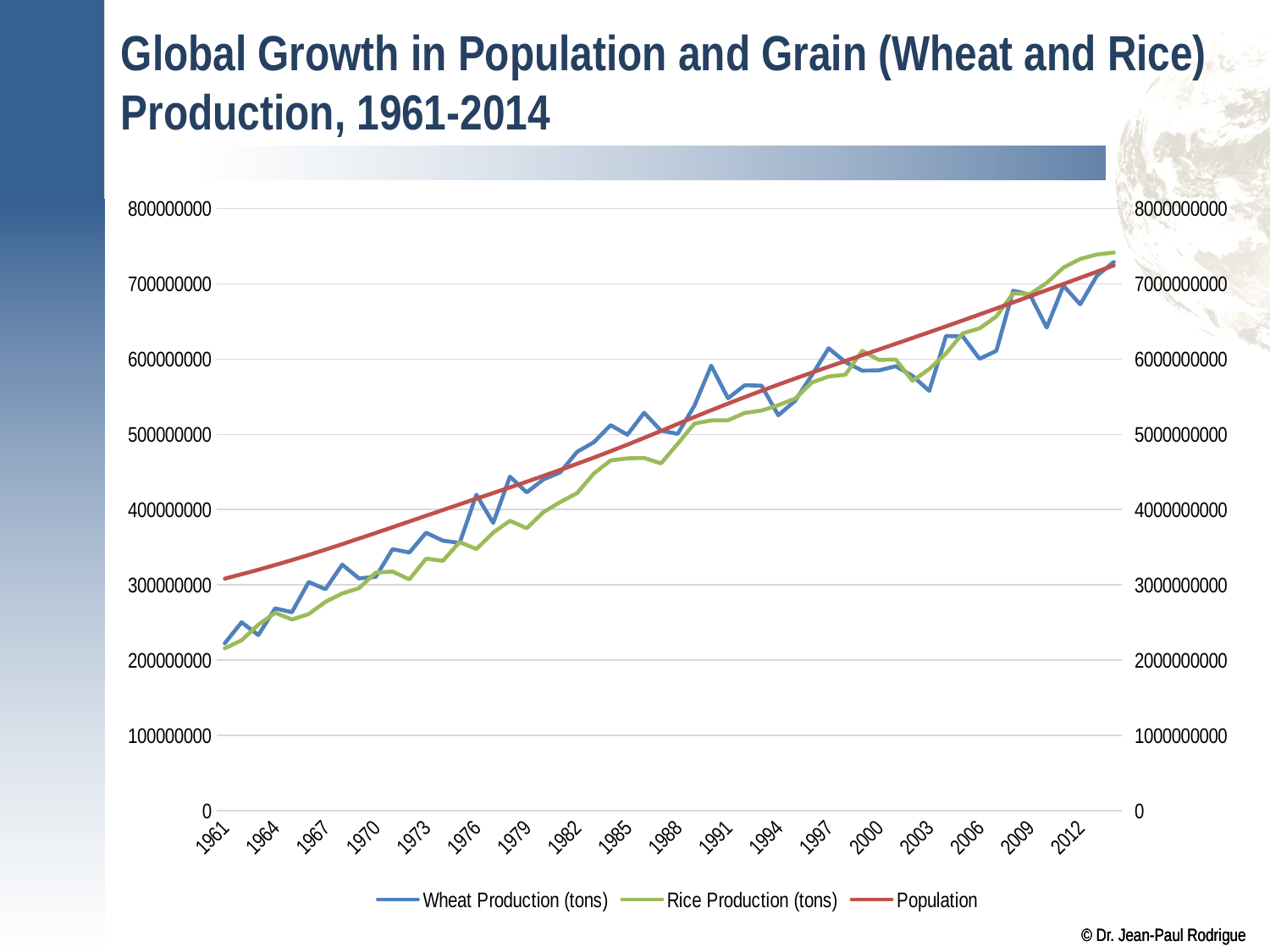
What are the three series listed in the legend? Wheat Production (tons), Rice Production (tons), Population Is the value for Population in 1991 greater or less than 5000000000 on the right axis? greater Is the value for Rice Production (tons) in 2012 greater or less than 700000000? greater Does wheat production rise or fall overall from 1961 to 2014? rise In 1979, which is higher, Wheat Production (tons) or Rice Production (tons)? Wheat Production (tons) How many series does the legend list? 3 Is the value for Wheat Production (tons) in 1961 greater or less than 300000000? less What colour is the Population line? red What kind of chart is shown on the slide? line chart Does the Population line rise or fall across the years shown? rise